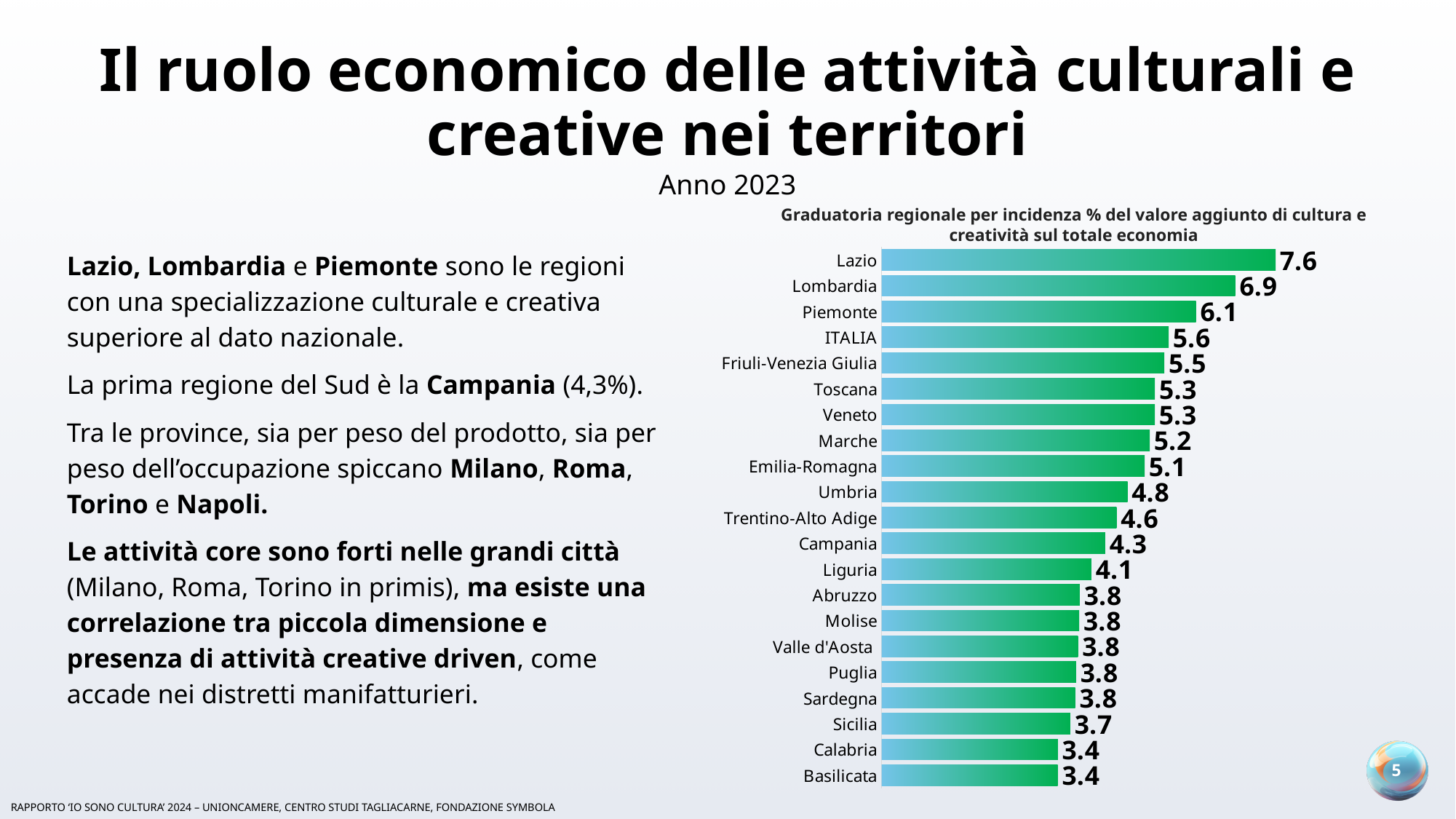
What is the value for Campania? 4.3 What is the value for Lazio? 7.6 What is the difference between the values for Piemonte and ITALIA? 0.5 How many bars are shown in the chart? 21 Which region has the highest value? Lazio What is the difference between the values for Lazio and Lombardia? 0.7 What is the title of the chart? Graduatoria regionale per incidenza % del valore aggiunto di cultura e creatività sul totale economia What kind of chart is shown on the slide? Bar chart What is the value for ITALIA? 5.6 Which has a larger value, Umbria or Campania? Umbria What is the value for Trentino-Alto Adige? 4.6 What is the lowest value shown in the chart? 3.4